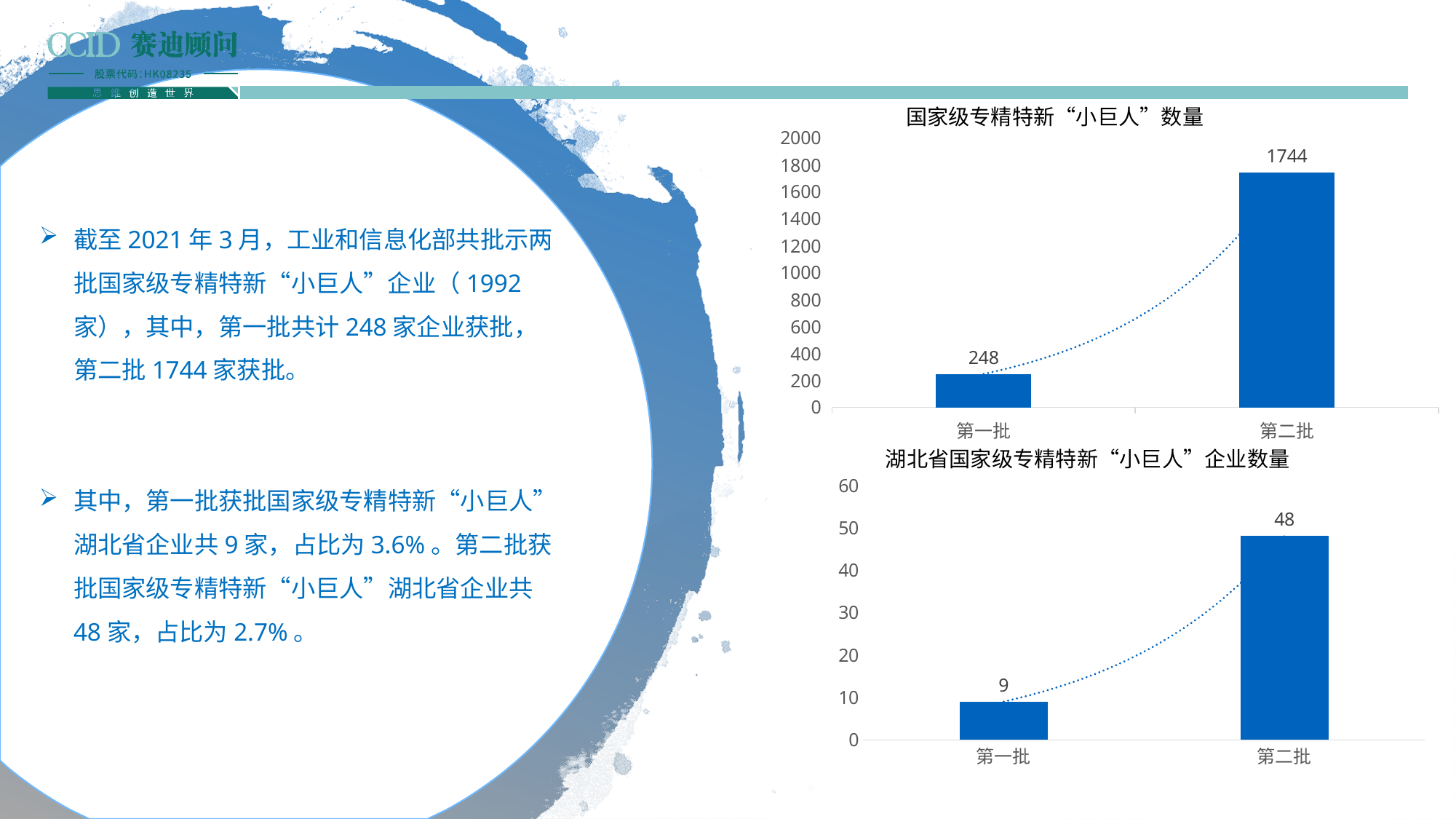
In the chart titled 国家级专精特新“小巨人”数量, how many categories are shown on the x axis? 2 In the chart titled 湖北省国家级专精特新“小巨人”企业数量, what is the value for 第一批? 9 In the chart titled 湖北省国家级专精特新“小巨人”企业数量, is the value for 第二批 greater or less than 40? greater In the chart titled 国家级专精特新“小巨人”数量, what is the difference between 第二批 and 第一批? 1496 In the chart titled 湖北省国家级专精特新“小巨人”企业数量, which category has the lowest value? 第一批 What kind of chart is the upper chart titled 国家级专精特新“小巨人”数量? bar chart In the chart titled 湖北省国家级专精特新“小巨人”企业数量, do the values rise or fall from 第一批 to 第二批? rise In the chart titled 国家级专精特新“小巨人”数量, what is the value for 第二批? 1744 In the chart titled 湖北省国家级专精特新“小巨人”企业数量, what is the difference between 第二批 and 第一批? 39 In the chart titled 国家级专精特新“小巨人”数量, what is the value for 第一批? 248 In the chart titled 国家级专精特新“小巨人”数量, which category has the highest value? 第二批 In the chart titled 湖北省国家级专精特新“小巨人”企业数量, what is the value for 第二批? 48